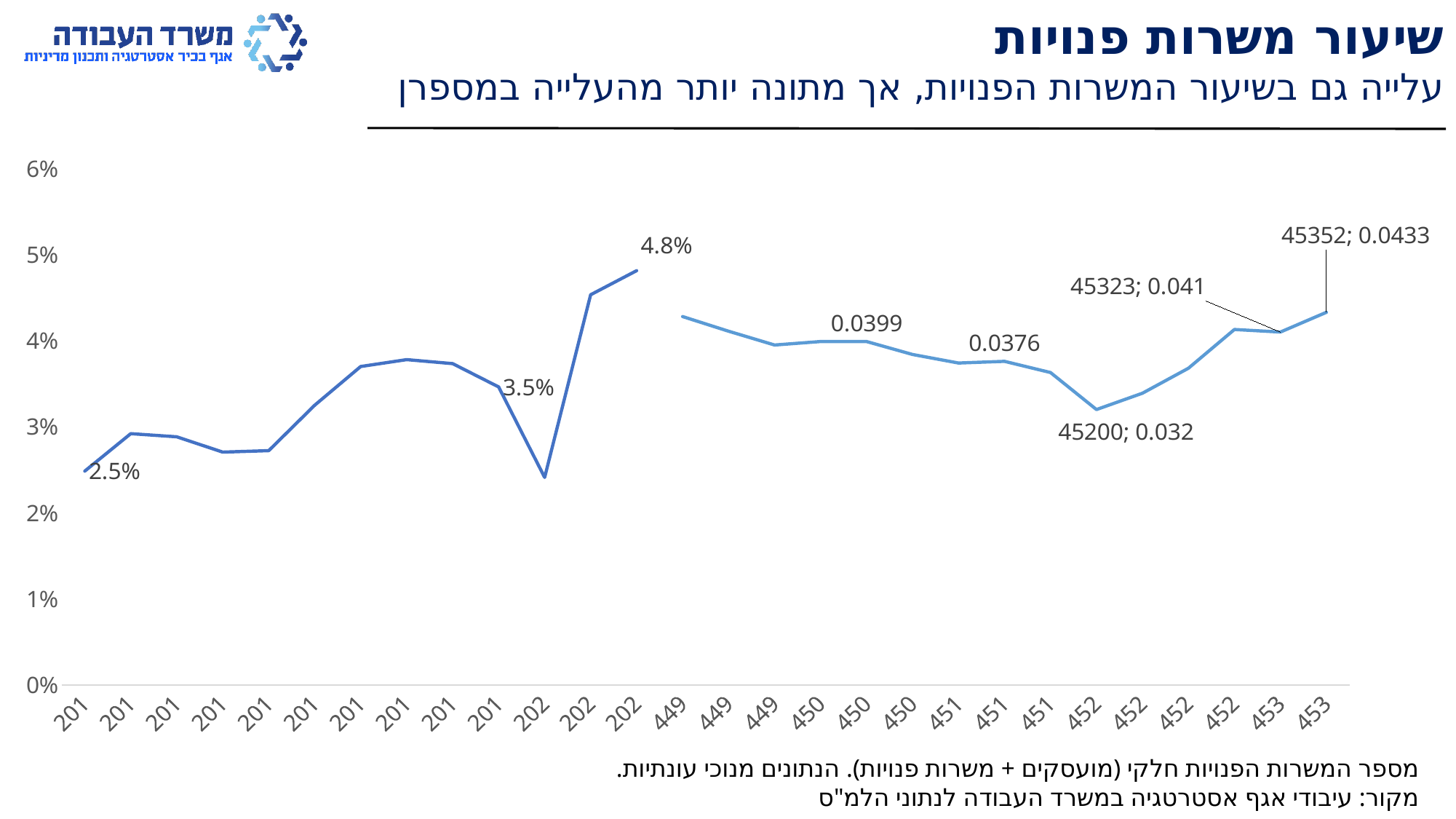
Overall, does the dark blue line rise or fall from its first point to its last point? rise Which is larger: the dark blue line's label of 4.8% or its label of 3.5%? 4.8% What data label is printed at the last point of the light blue line? 45352; 0.0433 What is the highest value shown on the vertical axis? 6% What is the value printed at the last (highest) point of the dark blue line? 4.8% What is the value printed at the first point of the dark blue line? 2.5% How many lines are plotted on the chart? 2 What data label is printed at the lowest point of the light blue line? 45200; 0.032 What is the difference between the last labelled value of the dark blue line (4.8%) and its first labelled value (2.5%)? 2.3 percentage points What kind of chart is shown on the slide? line chart Is the lowest dip of the dark blue line (just before it rises to 4.8%) greater or less than 3%? less Is the first point of the light blue line greater or less than 4%? greater